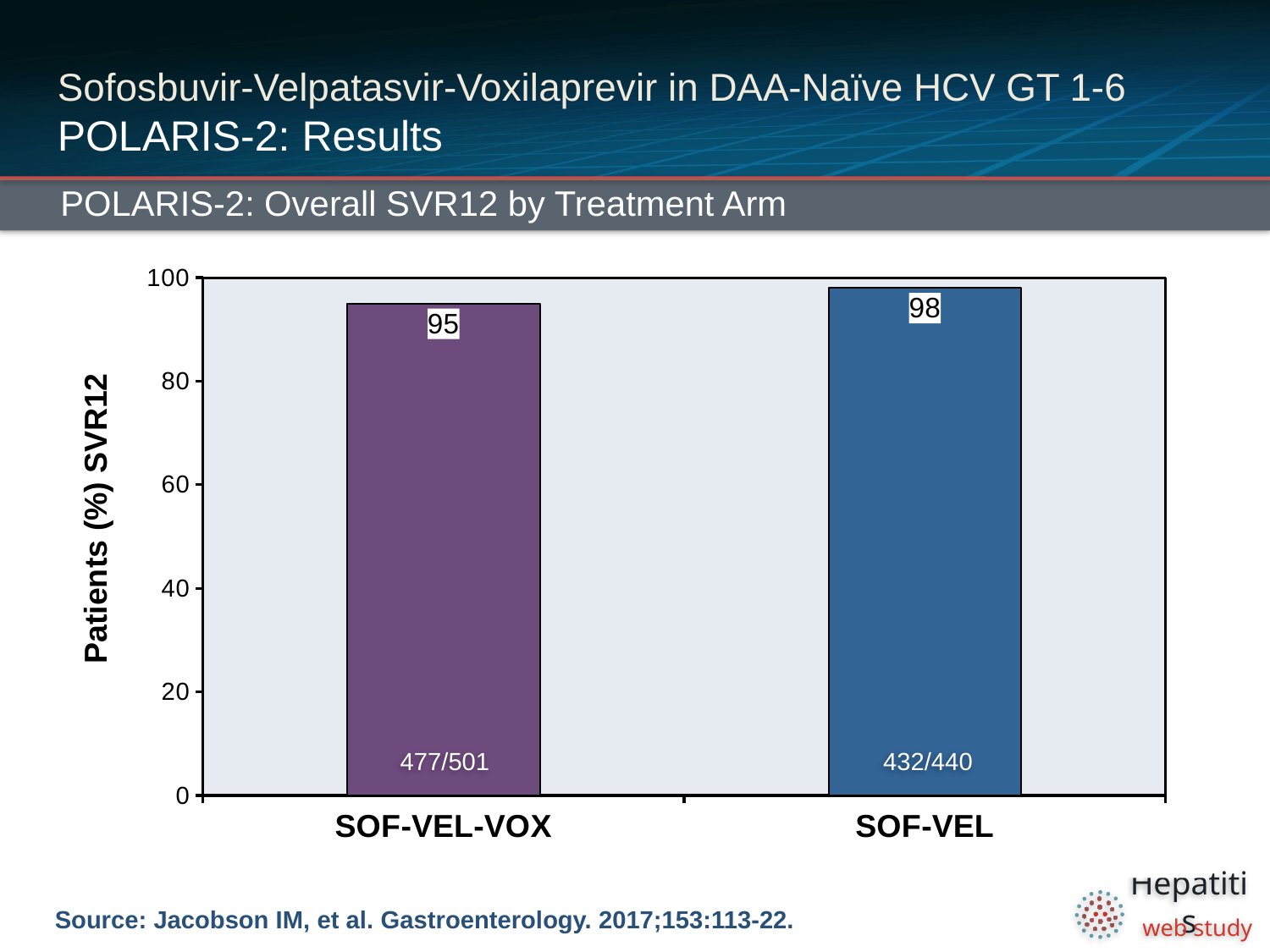
What is the SVR12 value for SOF-VEL-VOX? 95 What is the title of the chart? POLARIS-2: Overall SVR12 by Treatment Arm What kind of chart is shown on the slide? bar chart What fraction of patients is printed on the SOF-VEL-VOX bar? 477/501 Is the SVR12 value for SOF-VEL-VOX greater or less than 80? greater What is the label of the y axis? Patients (%) SVR12 What is the difference in SVR12 between SOF-VEL and SOF-VEL-VOX? 3 What fraction of patients is printed on the SOF-VEL bar? 432/440 Which treatment arm has the higher SVR12 rate? SOF-VEL What is the SVR12 value for SOF-VEL? 98 How many treatment arms are shown in the chart? 2 Which treatment arm has the lower SVR12 rate? SOF-VEL-VOX